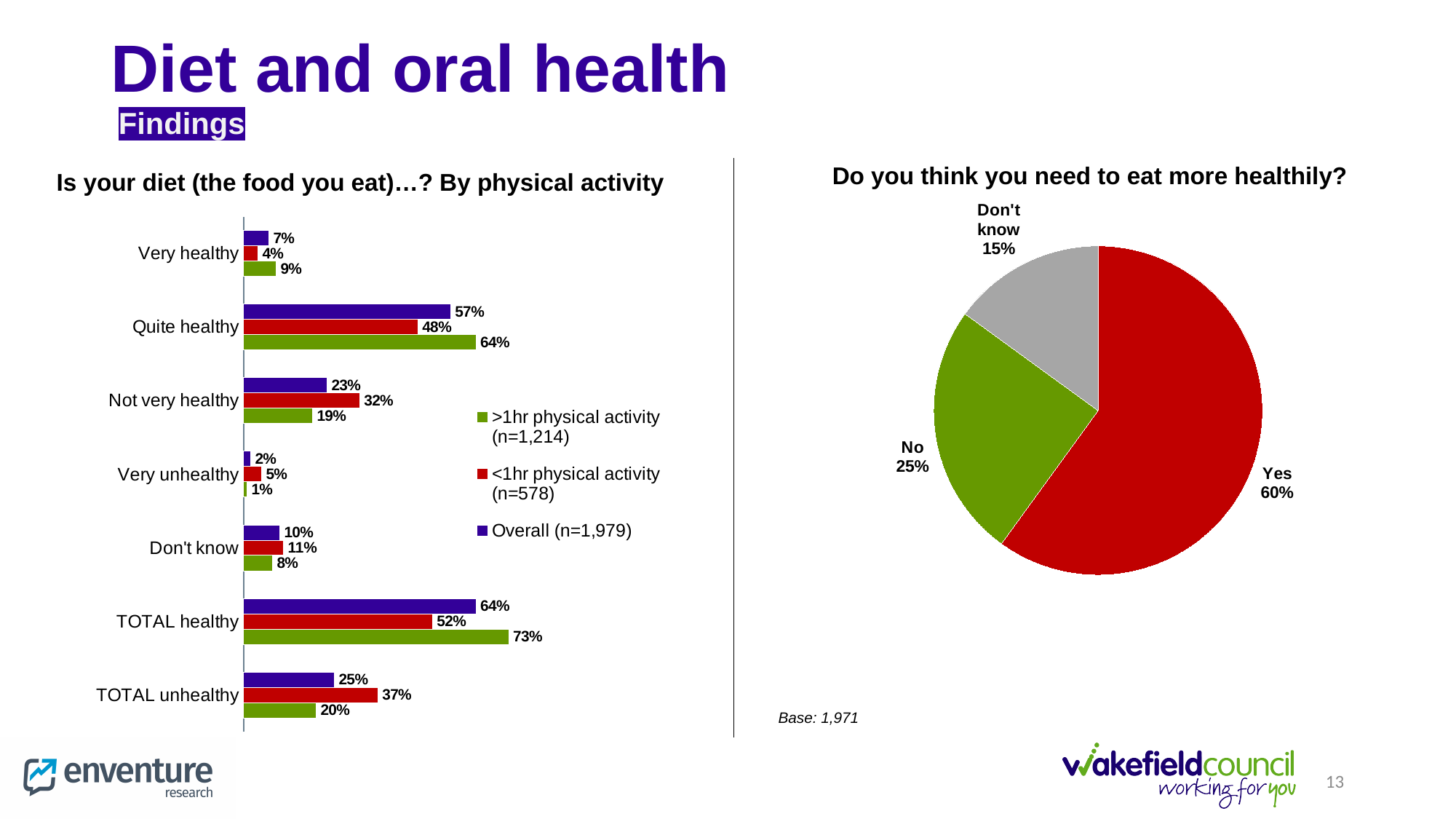
What kind of chart is 'Do you think you need to eat more healthily?'? Pie chart In the 'Do you think you need to eat more healthily?' pie chart, what share of respondents answered No? 25% How many categories are shown in the 'Is your diet (the food you eat)…? By physical activity' chart? 7 In the 'Is your diet (the food you eat)…? By physical activity' chart, what is the Overall value for Quite healthy? 57% In the 'Is your diet (the food you eat)…? By physical activity' chart, what is the value for TOTAL healthy among those with >1hr physical activity? 73% In the 'Is your diet (the food you eat)…? By physical activity' chart, which category has the lowest value for >1hr physical activity? Very unhealthy In the 'Do you think you need to eat more healthily?' pie chart, which slice is the largest? Yes In the 'Is your diet (the food you eat)…? By physical activity' chart, what is the value for TOTAL unhealthy among those with <1hr physical activity? 37% In the 'Is your diet (the food you eat)…? By physical activity' chart, which is larger for Not very healthy: the <1hr physical activity value or the >1hr physical activity value? <1hr physical activity How many series does the legend of the 'Is your diet (the food you eat)…? By physical activity' chart list? 3 In the 'Is your diet (the food you eat)…? By physical activity' chart, which category has the highest Overall value? TOTAL healthy In the 'Is your diet (the food you eat)…? By physical activity' chart, what is the difference between the >1hr and <1hr physical activity values for Quite healthy? 16%